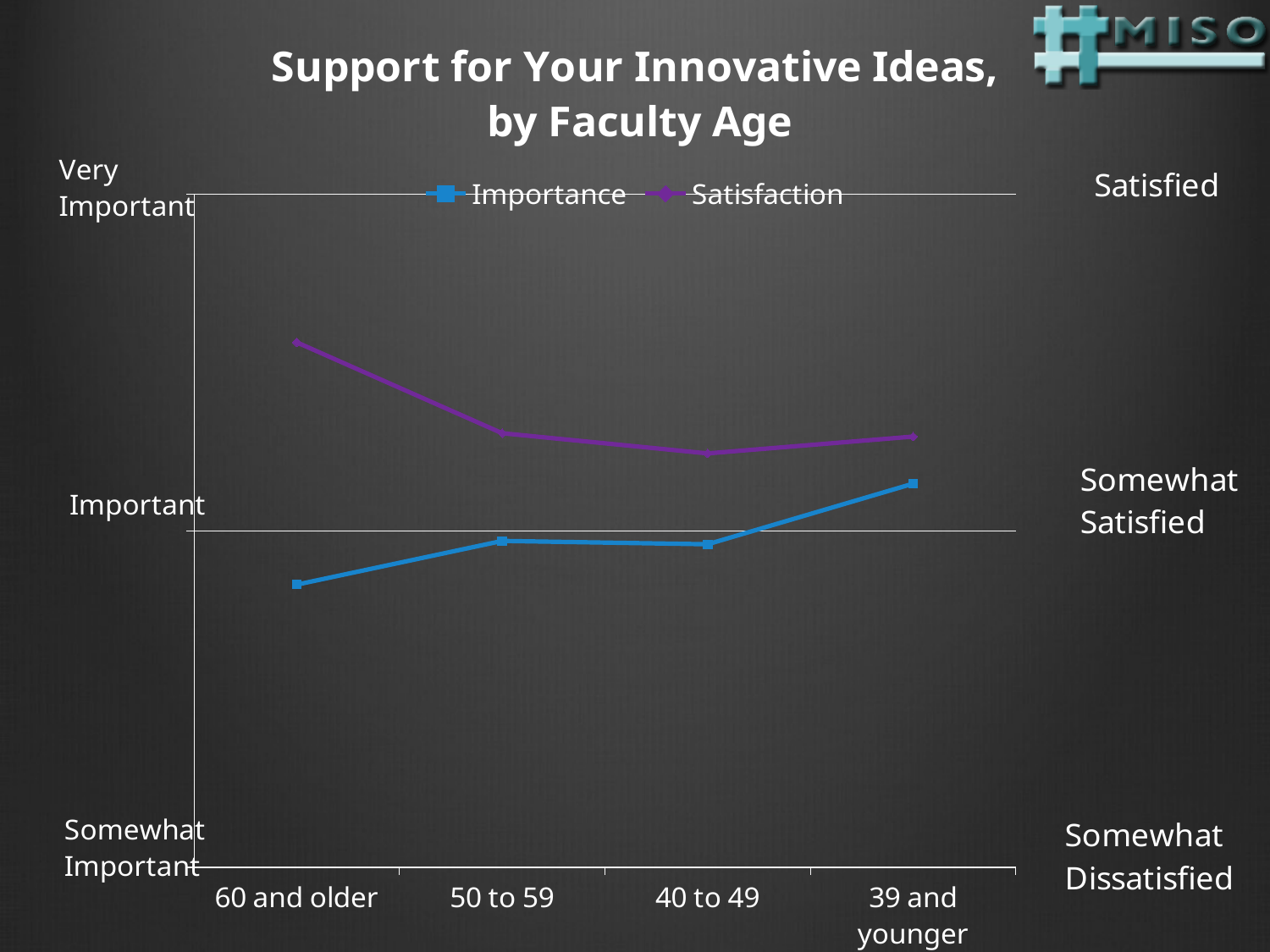
What colour is the Importance line? blue How many series does the legend list? 2 Does the Importance line rise or fall from 60 and older to 39 and younger? rises How many faculty age groups are shown on the x axis? 4 What kind of chart is shown on the slide? line chart Is the Importance value larger for 39 and younger or for 60 and older? 39 and younger What is the title of the chart? Support for Your Innovative Ideas, by Faculty Age For the 60 and older group, which series is plotted higher, Importance or Satisfaction? Satisfaction Which faculty age group has the highest Importance value? 39 and younger Which faculty age group has the highest Satisfaction value? 60 and older Which faculty age group has the lowest Satisfaction value? 40 to 49 Which faculty age group has the lowest Importance value? 60 and older